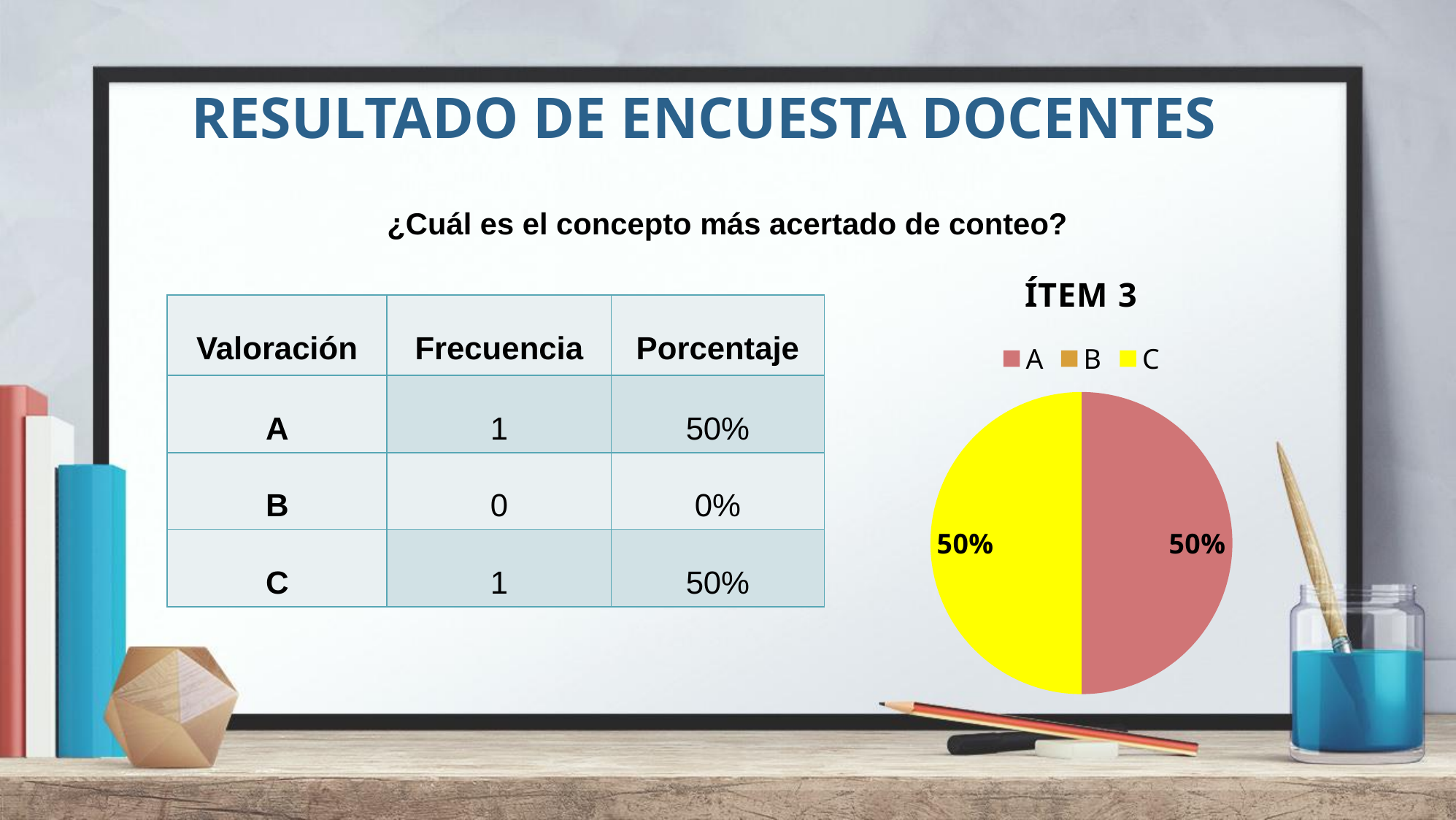
Is the share of slice A in the pie chart greater or less than 25%? greater What share of the pie chart does slice C represent? 50% What kind of chart is shown on the slide? pie chart What is the difference between the shares of slice A and slice C in the pie chart? 0% Which colour is used for slice C in the pie chart? yellow What share of the pie chart does slice A represent? 50% How many slices in the pie chart carry a percentage data label? 2 How many entries does the legend of the pie chart list? 3 What is the title of the pie chart? ÍTEM 3 Is the share of slice C in the pie chart greater or less than 75%? less